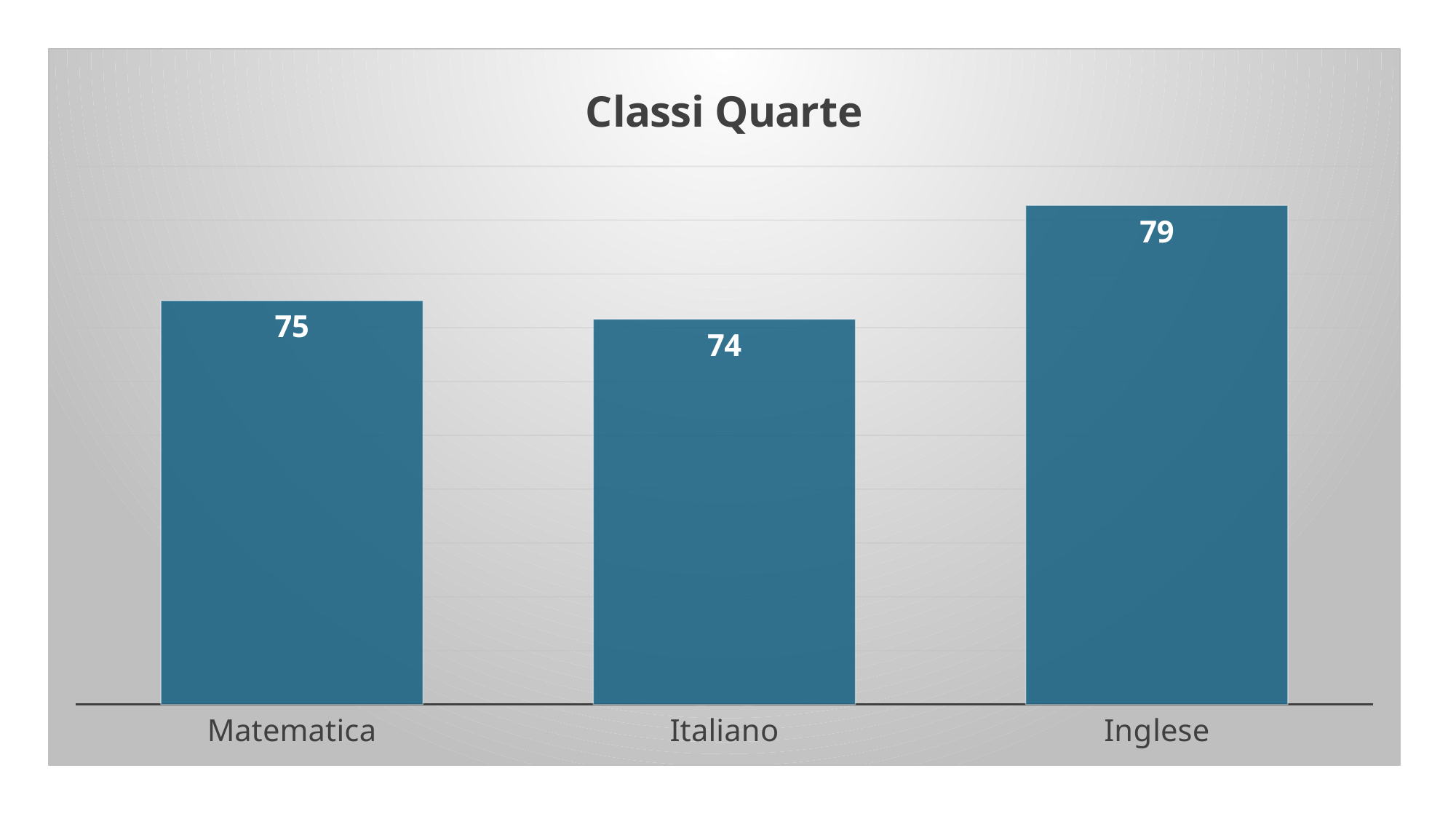
What colour are the bars in the chart? blue What is the difference between the values for Inglese and Matematica? 4 What is the difference between the values for Matematica and Italiano? 1 Which category has the lowest value? Italiano What is the value for Inglese? 79 What is the value for Italiano? 74 Which is larger, the value for Inglese or the value for Italiano? Inglese What is the title of the chart? Classi Quarte Which category has the highest value? Inglese How many categories are shown in the chart? 3 What kind of chart is shown on the slide? bar chart What is the value for Matematica? 75